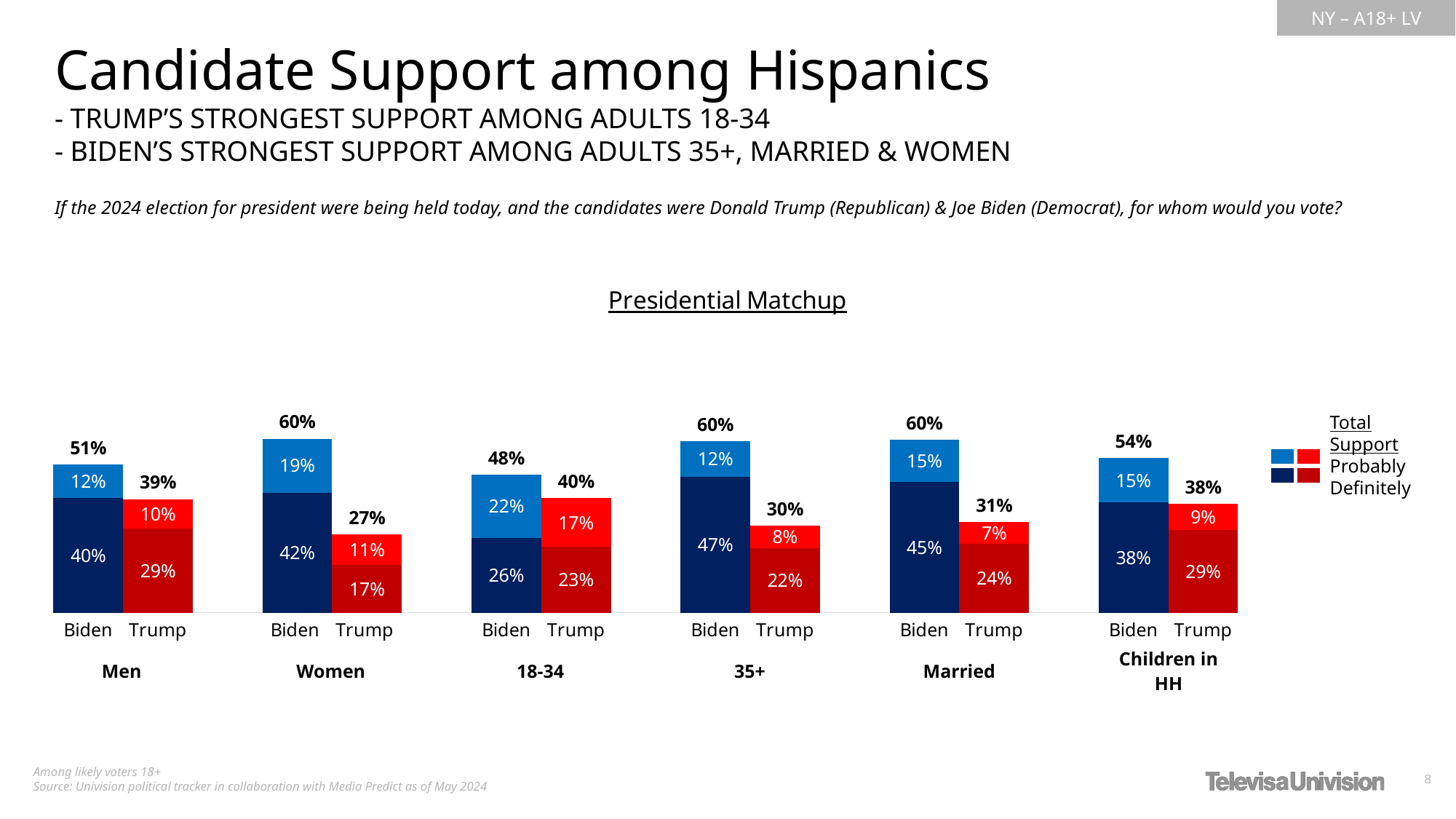
In which group is Trump's total support lowest? Women What share of respondents with Children in HH say they would probably vote for Trump? 9% What share of adults 18-34 say they would definitely vote for Trump? 23% What kind of chart is shown on the slide? Stacked bar chart What is Trump's total support among Married respondents? 31% Is the share who would definitely vote for Biden larger among Married respondents or among those with Children in HH? Married What share of Women say they would probably vote for Biden? 19% In which group is Trump's total support highest? 18-34 In which group is Biden's total support lowest? 18-34 What is Biden's total support among Men? 51% How many demographic groups are shown in the chart? 6 Among adults 35+, how many percentage points higher is Biden's total support than Trump's? 30 percentage points